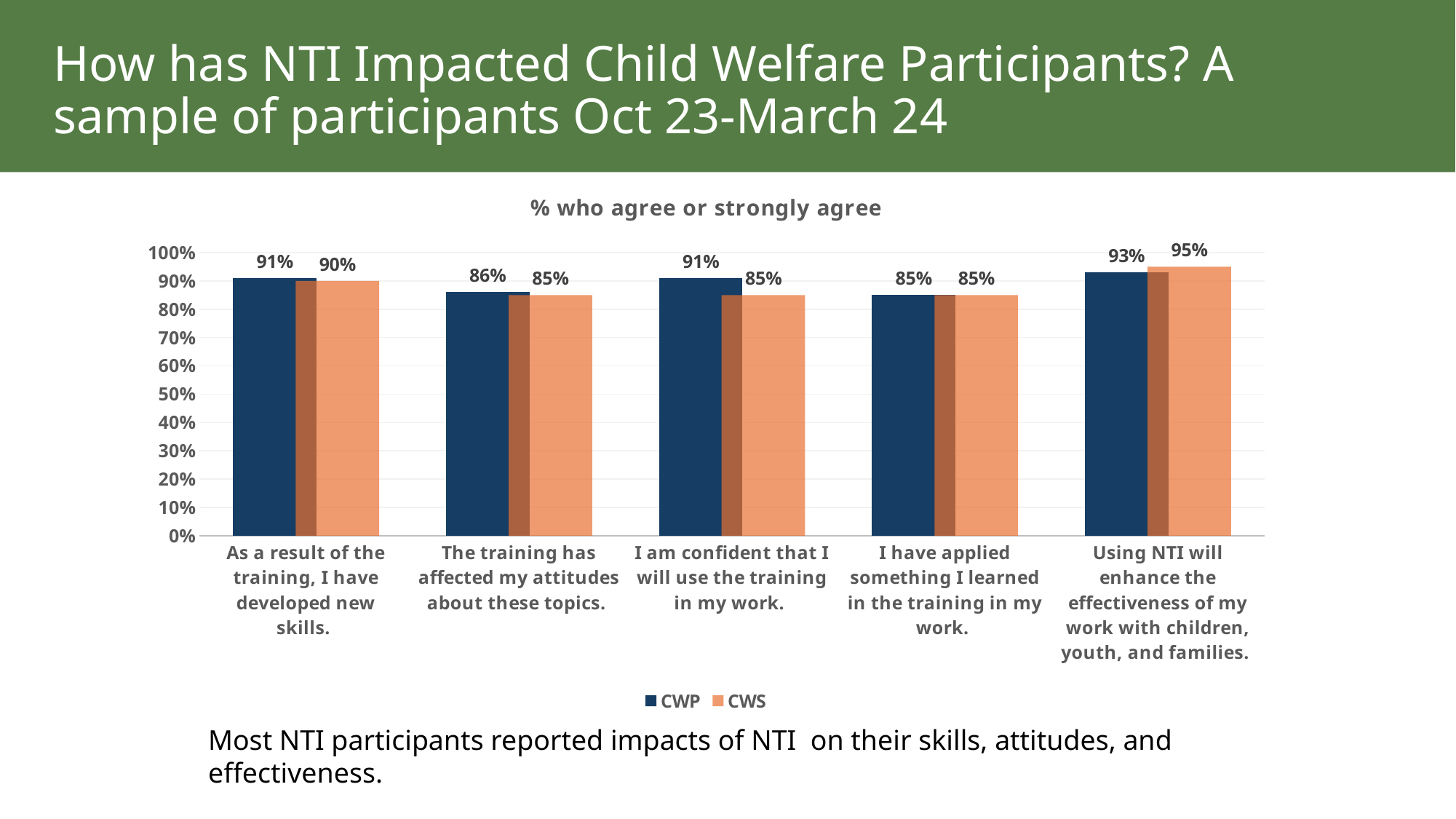
Which series is shown in orange in the legend? CWS For "Using NTI will enhance the effectiveness of my work with children, youth, and families.", which series has the larger value, CWP or CWS? CWS How many categories are shown on the x axis? 5 Which category has the highest CWS value? Using NTI will enhance the effectiveness of my work with children, youth, and families. What kind of chart is shown on the slide? Bar chart What is the difference between the CWP and CWS values for "I am confident that I will use the training in my work."? 6% How many series does the legend list? 2 What is the title of the chart? % who agree or strongly agree What is the CWS value for "The training has affected my attitudes about these topics."? 85% What is the CWS value for "Using NTI will enhance the effectiveness of my work with children, youth, and families."? 95% Which category has the lowest CWP value? I have applied something I learned in the training in my work. What is the CWP value for "As a result of the training, I have developed new skills."? 91%